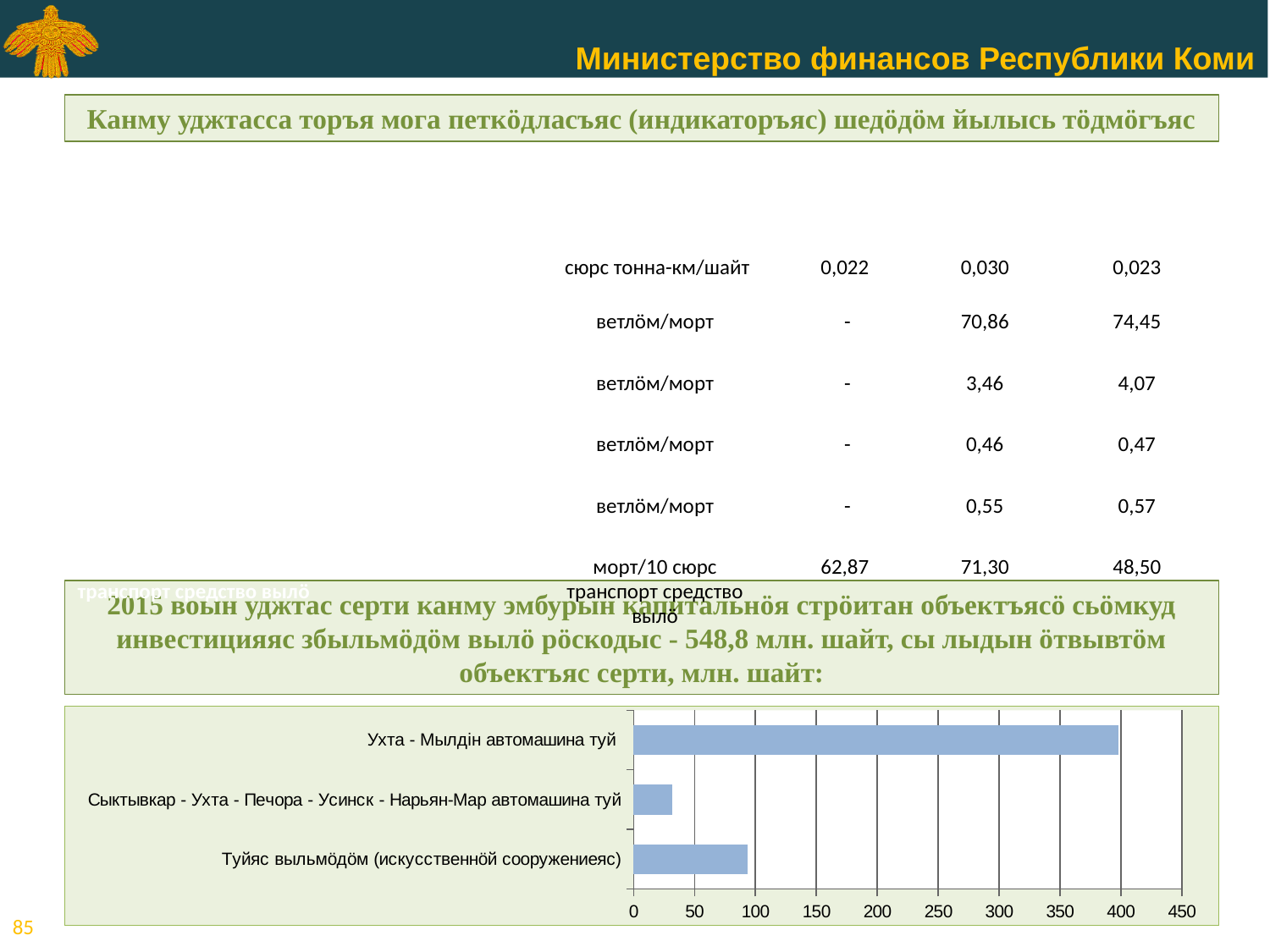
Is the value for Ухта - Мылдін автомашина туй greater or less than 450? less How many categories does the bar chart show? 3 What kind of chart is shown at the bottom of the slide? bar chart Is the value for Ухта - Мылдін автомашина туй greater or less than 350? greater Which category has the highest value in the bar chart? Ухта - Мылдін автомашина туй According to the text above the bar chart, what total amount in million rubles was spent on capital construction investments in 2015? 548,8 млн. шайт Is the value for Сыктывкар - Ухта - Печора - Усинск - Нарьян-Мар автомашина туй greater or less than 50? less Which category has the lowest value in the bar chart? Сыктывкар - Ухта - Печора - Усинск - Нарьян-Мар автомашина туй Which is larger in the bar chart: the value for Туйяс выльмöдöм (искусственнöй сооружениеяс) or the value for Сыктывкар - Ухта - Печора - Усинск - Нарьян-Мар автомашина туй? Туйяс выльмöдöм (искусственнöй сооружениеяс) What is the highest tick value shown on the horizontal axis of the bar chart? 450